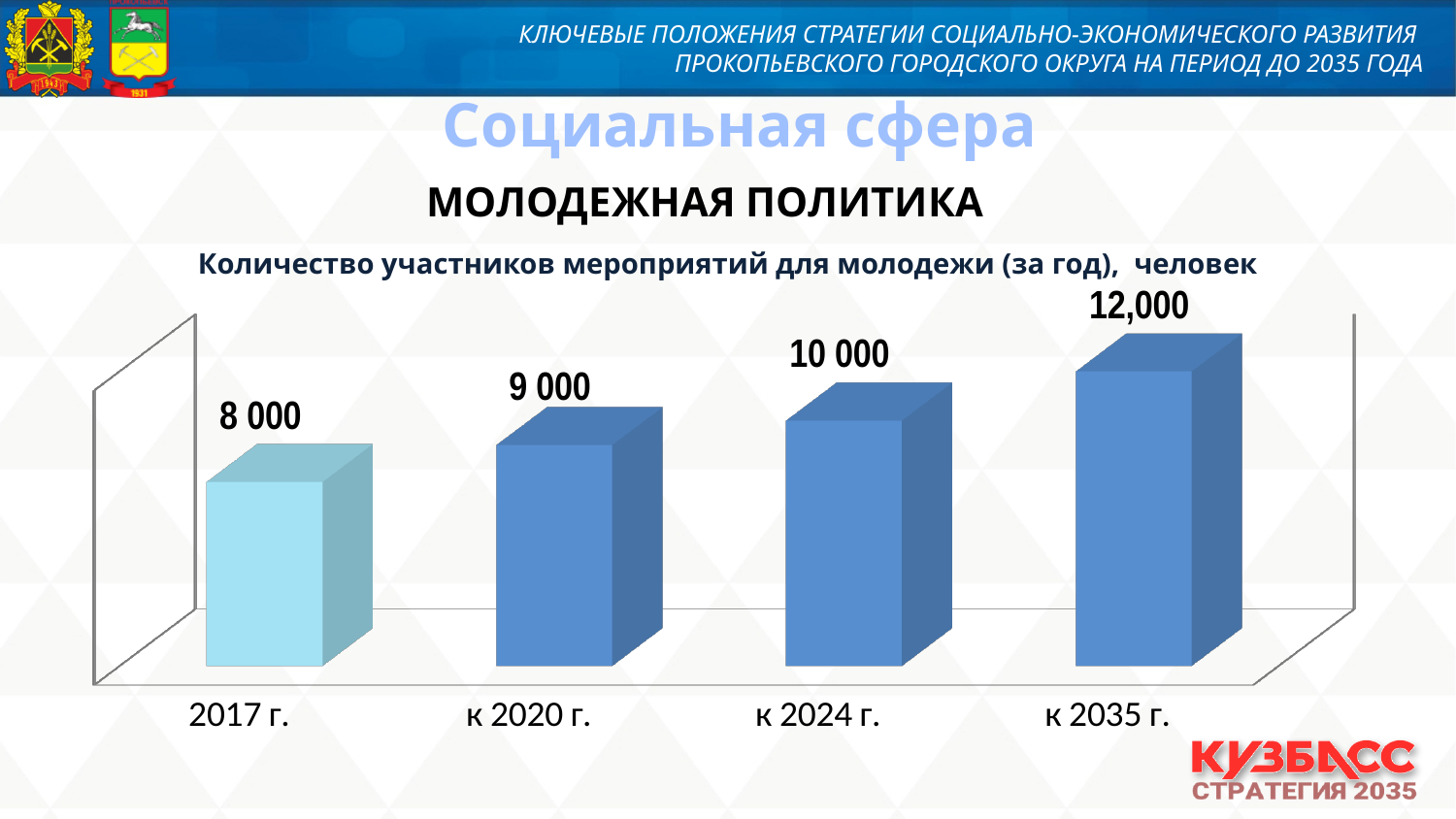
How many categories are shown on the chart? 4 What is the value for к 2035 г.? 12,000 What is the value for к 2024 г.? 10 000 Do the values rise or fall from 2017 г. to к 2035 г.? Rise Which category has the lowest value? 2017 г. What kind of chart is shown on the slide? Bar chart What is the value for к 2020 г.? 9 000 What is the difference between the values for к 2024 г. and к 2020 г.? 1 000 What is the difference between the values for к 2035 г. and 2017 г.? 4 000 Which category has the highest value? к 2035 г. Which is larger, the value for к 2020 г. or the value for к 2024 г.? к 2024 г. What is the value for 2017 г.? 8 000